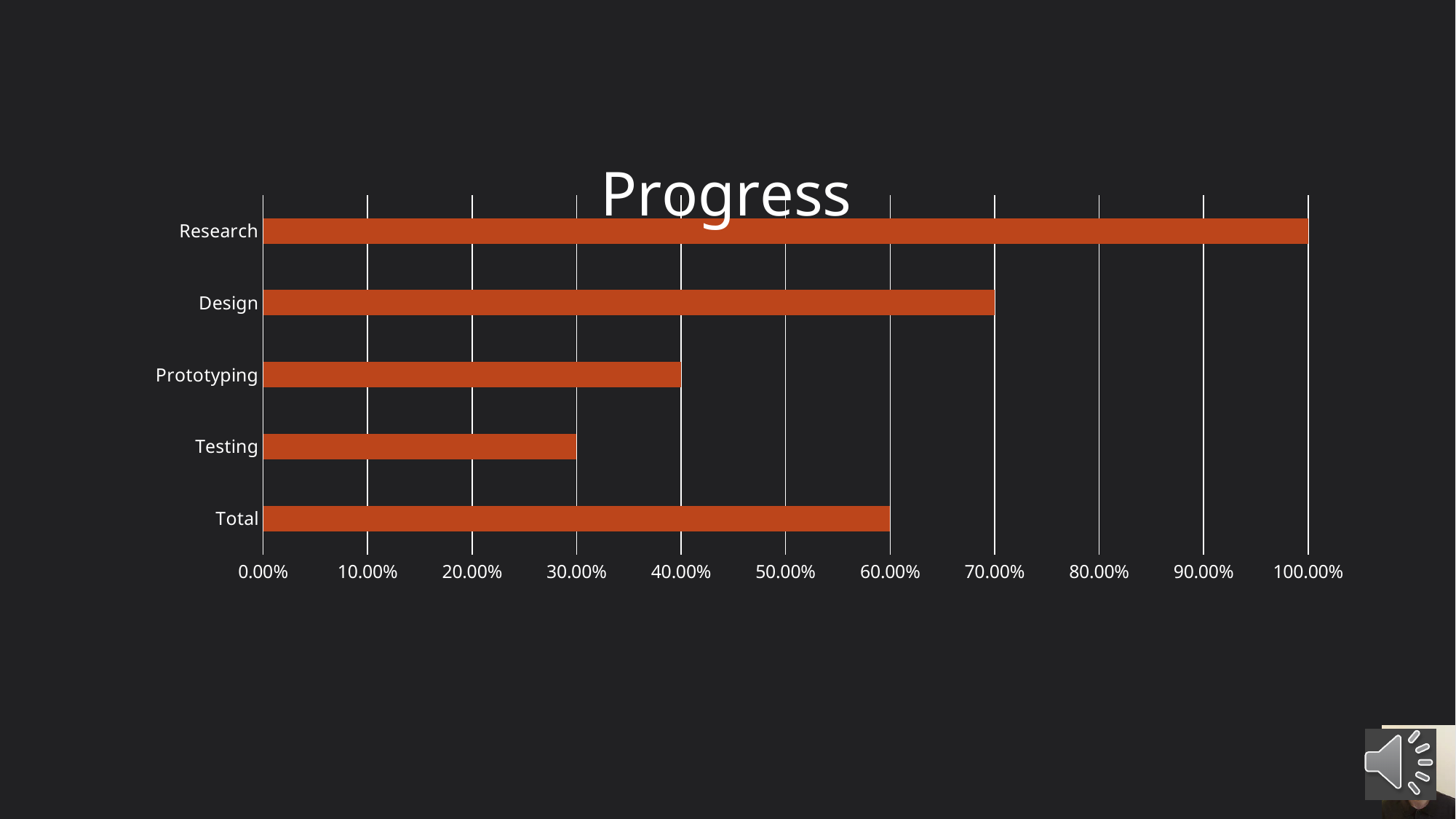
What is the value for Testing? 30.00% What is the value for Design? 70.00% Which category has the highest value? Research What is the value for Total? 60.00% What is the difference between the values for Design and Prototyping? 30.00% Which is larger, the value for Total or the value for Prototyping? Total What type of chart is shown on the slide? bar chart Which category has the lowest value? Testing What is the title of the chart? Progress How many categories are plotted in the chart? 5 What is the value for Research? 100.00% What is the value for Prototyping? 40.00%